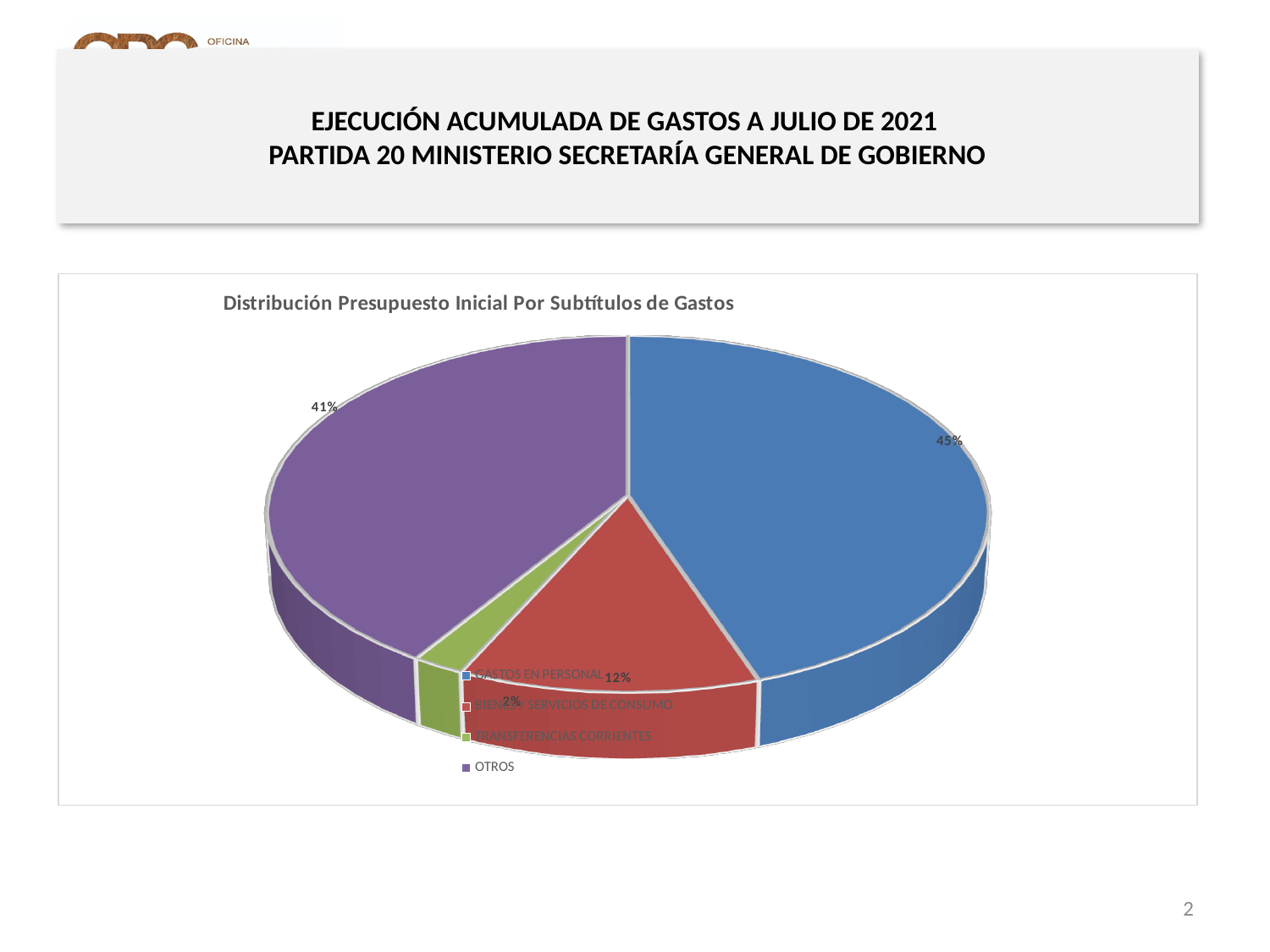
Which is larger, the share for BIENES Y SERVICIOS DE CONSUMO or the share for TRANSFERENCIAS CORRIENTES? BIENES Y SERVICIOS DE CONSUMO Which category has the smallest slice of the pie? TRANSFERENCIAS CORRIENTES What share of the pie does OTROS represent? 41% What type of chart is shown on the slide? Pie chart What colour is the slice for OTROS? Purple What share of the pie does TRANSFERENCIAS CORRIENTES represent? 2% Which category has the largest slice of the pie? GASTOS EN PERSONAL What is the title of the chart? Distribución Presupuesto Inicial Por Subtítulos de Gastos How many categories does the pie chart have? 4 What share of the pie does BIENES Y SERVICIOS DE CONSUMO represent? 12% What is the difference in percentage points between GASTOS EN PERSONAL and OTROS? 4 percentage points